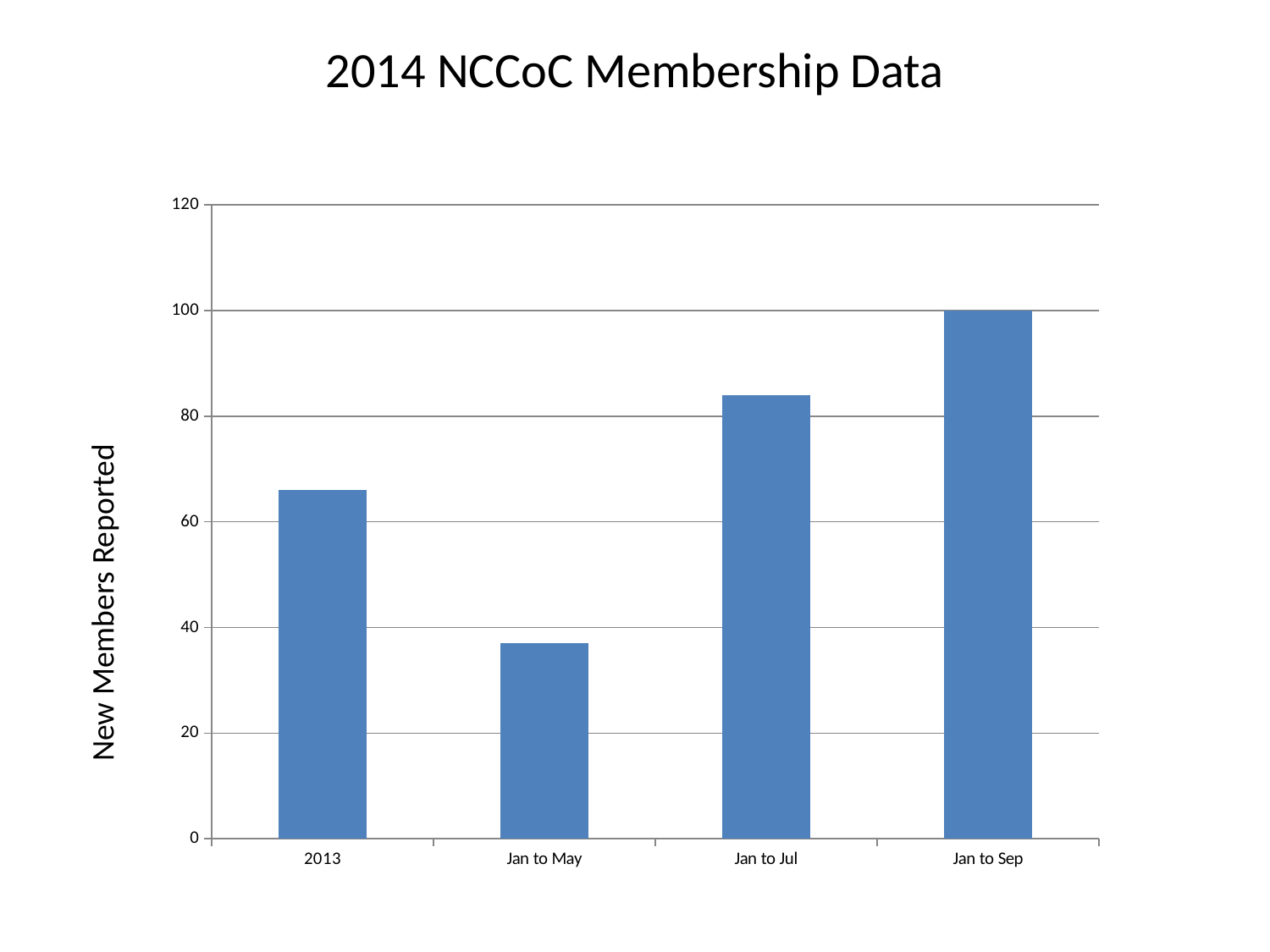
What type of chart is shown on the slide? bar chart How many categories are shown on the x axis? 4 Is the value for Jan to May greater or less than 40? less What is the value for Jan to Sep? 100 Which is larger, the value for 2013 or the value for Jan to Jul? Jan to Jul What is the label of the vertical axis? New Members Reported Which category has the lowest number of new members reported? Jan to May Do the values rise or fall from Jan to May through Jan to Sep? rise Is the value for Jan to Jul greater or less than 80? greater Is the value for 2013 greater or less than 60? greater Which category has the highest number of new members reported? Jan to Sep What is the title of the chart? 2014 NCCoC Membership Data